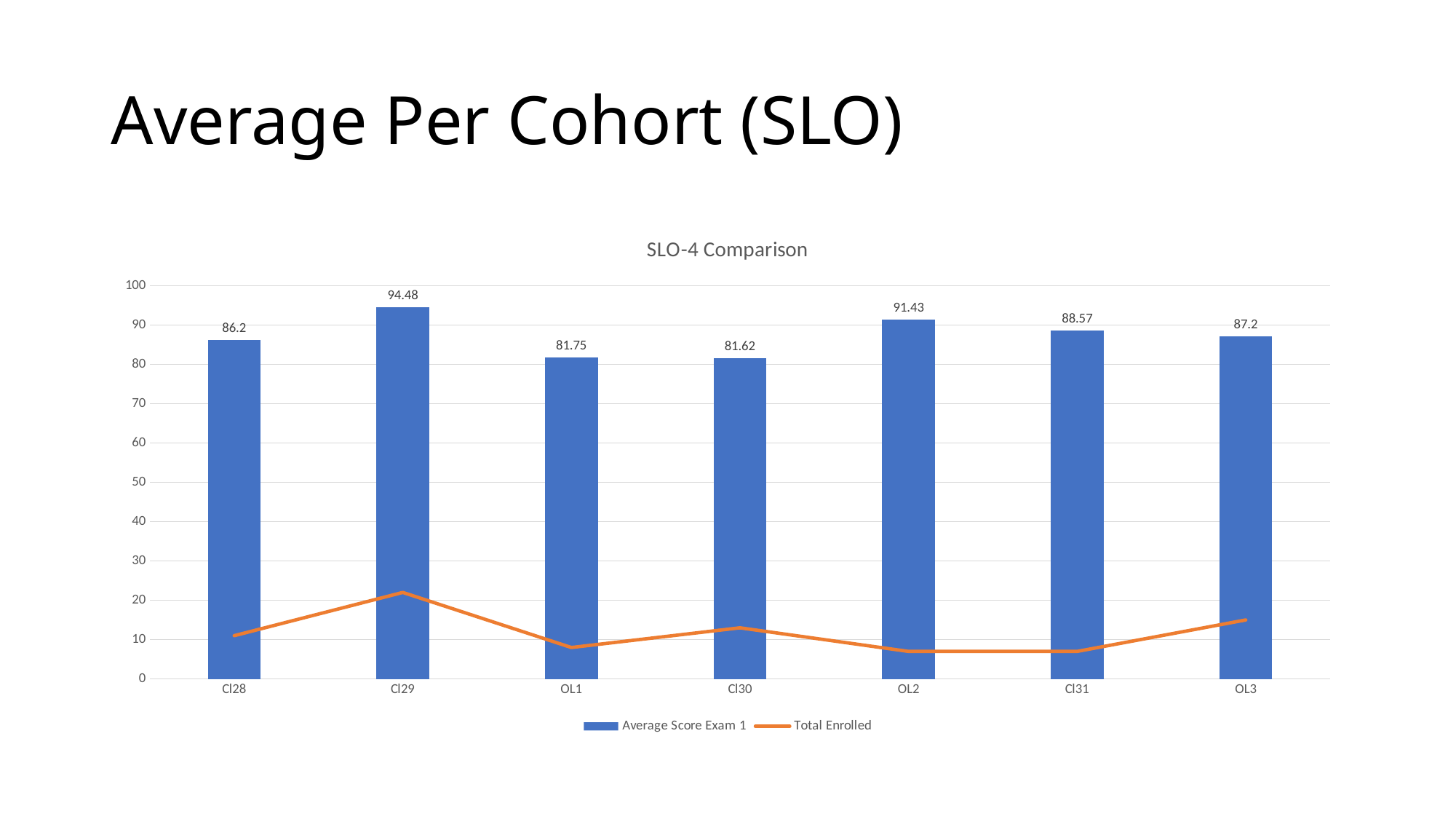
Which cohort has the highest Average Score Exam 1? Cl29 What is the Average Score Exam 1 value for OL2? 91.43 Is the Total Enrolled value for OL2 greater or less than 10? less What is the title of the chart? SLO-4 Comparison How many cohorts are shown on the x axis? 7 What is the Average Score Exam 1 value for Cl29? 94.48 What is the Average Score Exam 1 value for Cl31? 88.57 What is the difference between the Average Score Exam 1 values for Cl29 and Cl28? 8.28 Which has a higher Average Score Exam 1, OL2 or OL3? OL2 How many series does the legend list? 2 Is the Total Enrolled value for Cl29 greater or less than 10? greater Which cohort has the lowest Average Score Exam 1? Cl30